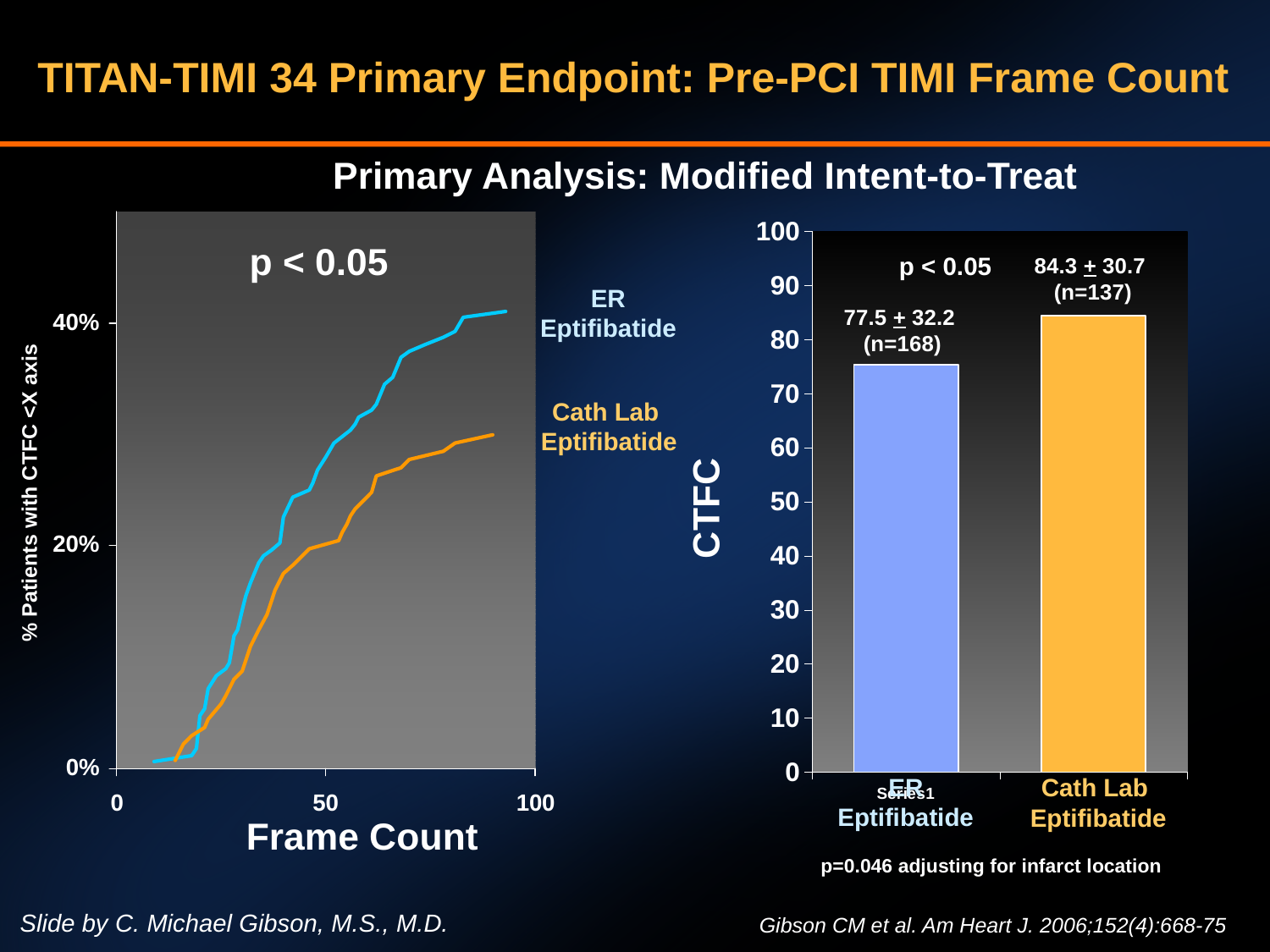
In the bar chart on the right, what is the sample size (n) for the ER Eptifibatide group? n=168 In the bar chart on the right, which group has the higher mean CTFC? Cath Lab Eptifibatide What kind of chart is the chart on the right of the slide? Bar chart In the bar chart on the right, how many bars are plotted? 2 In the line chart on the left, is the value for Cath Lab Eptifibatide at a Frame Count of 90 greater or less than 40%? less In the bar chart on the right, what is the CTFC value shown for Cath Lab Eptifibatide? 84.3 + 30.7 In the bar chart on the right, what is the sample size (n) for the Cath Lab Eptifibatide group? n=137 In the bar chart on the right, what is the CTFC value shown for ER Eptifibatide? 77.5 + 32.2 In the bar chart on the right, what is the difference between the mean CTFC of Cath Lab Eptifibatide and ER Eptifibatide? 6.8 What kind of chart is the chart on the left of the slide? Line chart In the line chart on the left, do the lines rise or fall as Frame Count increases? Rise In the line chart on the left, how many lines (series) are plotted? 2